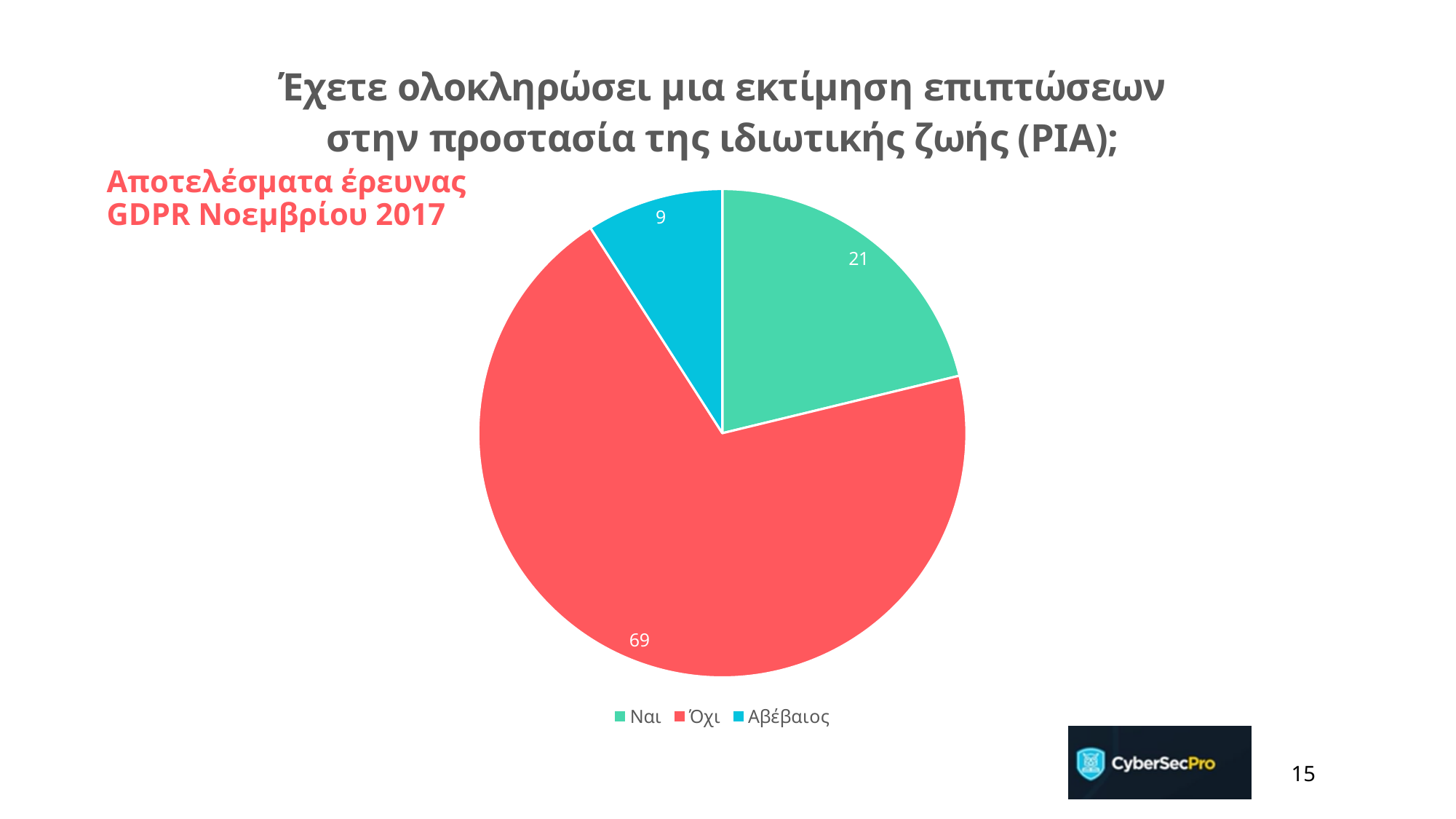
What is the difference between the values for Όχι and Ναι? 48 What is the value for Όχι? 69 How many entries does the legend list? 3 What type of chart is shown on the slide? pie chart What is the value for Αβέβαιος? 9 Which category has the largest slice? Όχι How many slices does the pie chart have? 3 Which is larger, the value for Ναι or the value for Αβέβαιος? Ναι What colour is the slice for Όχι? red What is the value for Ναι? 21 Which category has the smallest slice? Αβέβαιος What is the difference between the values for Ναι and Αβέβαιος? 12